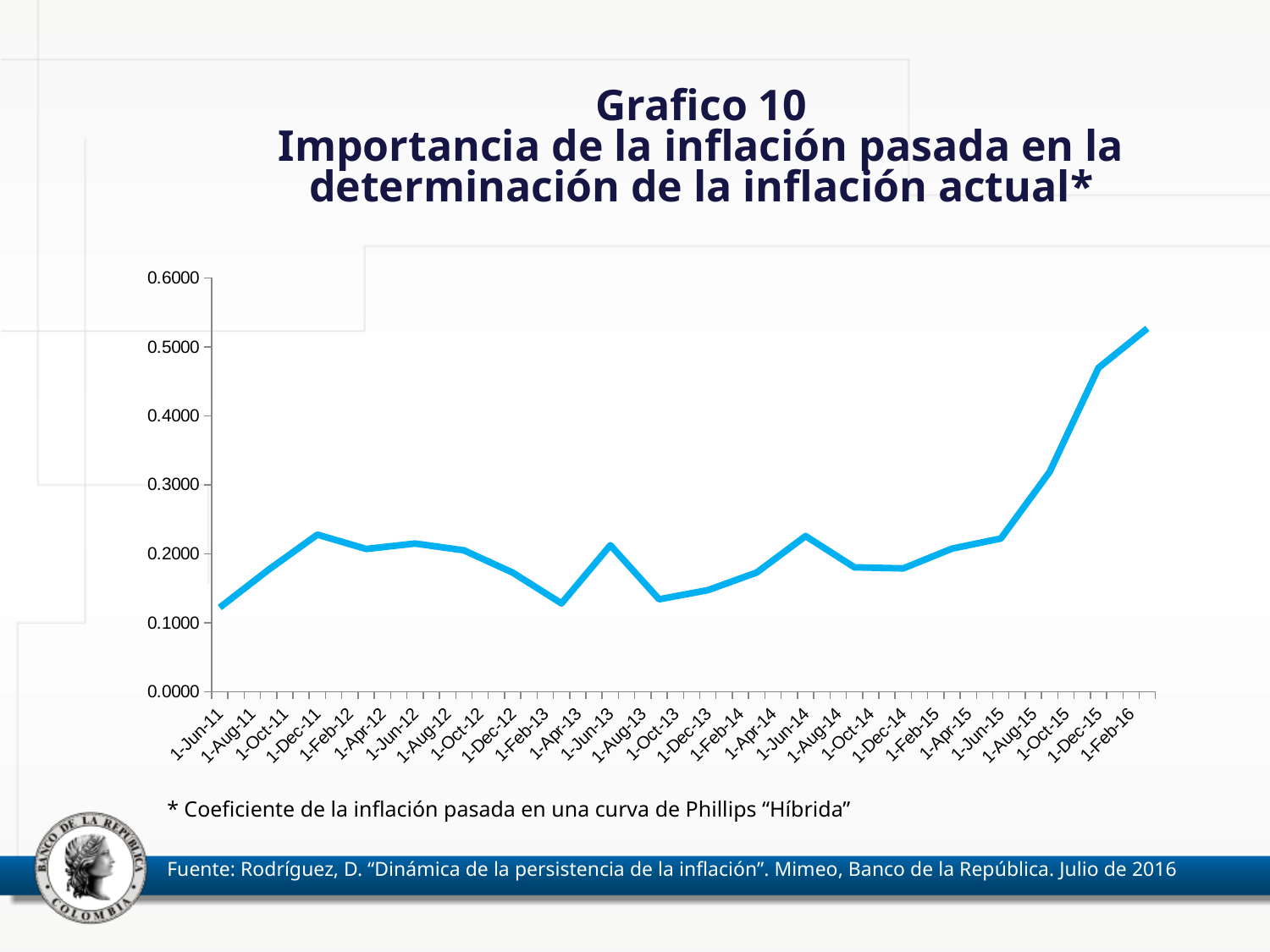
Overall, do the values rise or fall from 1-Jun-11 to 1-Feb-16? rise Which is larger, the value for 1-Dec-11 or the value for 1-Apr-13? 1-Dec-11 What is the first date label on the x axis? 1-Jun-11 What is the highest tick value shown on the y axis? 0.6000 Which is larger, the value for 1-Feb-16 or the value for 1-Jun-11? 1-Feb-16 Is the value for 1-Dec-15 greater or less than 0.5000? less What kind of chart is shown on the slide? line chart Is the value for 1-Oct-15 greater or less than 0.3000? greater Is the value for 1-Jun-11 greater or less than 0.2000? less